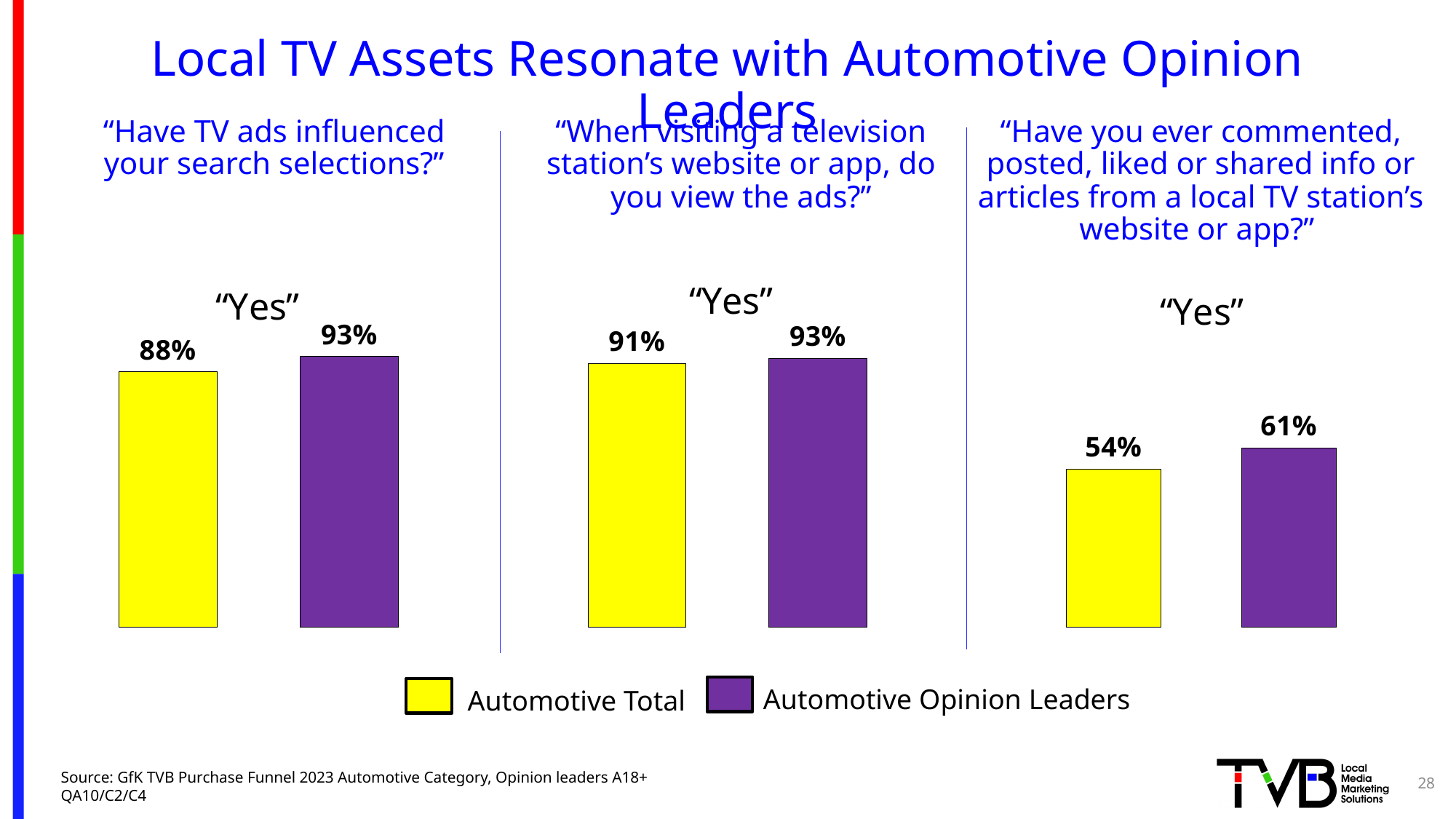
In the right chart ("Have you ever commented, posted, liked or shared info or articles from a local TV station's website or app?"), what is the difference between the Automotive Opinion Leaders value and the Automotive Total value? 7% In the left chart ("Have TV ads influenced your search selections?"), what is the value for Automotive Total? 88% In the middle chart ("When visiting a television station's website or app, do you view the ads?"), what is the value for Automotive Total? 91% In the left chart ("Have TV ads influenced your search selections?"), what is the difference between the Automotive Opinion Leaders value and the Automotive Total value? 5% According to the legend, which colour represents Automotive Opinion Leaders? Purple In the left chart ("Have TV ads influenced your search selections?"), what is the value for Automotive Opinion Leaders? 93% In the middle chart ("When visiting a television station's website or app, do you view the ads?"), which group has the higher value, Automotive Total or Automotive Opinion Leaders? Automotive Opinion Leaders How many series does the legend at the bottom of the slide list? 2 What kind of chart is used in the middle chart ("When visiting a television station's website or app, do you view the ads?")? Bar chart In the right chart ("Have you ever commented, posted, liked or shared info or articles from a local TV station's website or app?"), which group has the lower value? Automotive Total In the right chart ("Have you ever commented, posted, liked or shared info or articles from a local TV station's website or app?"), what is the value for Automotive Opinion Leaders? 61% In the right chart ("Have you ever commented, posted, liked or shared info or articles from a local TV station's website or app?"), what is the value for Automotive Total? 54%